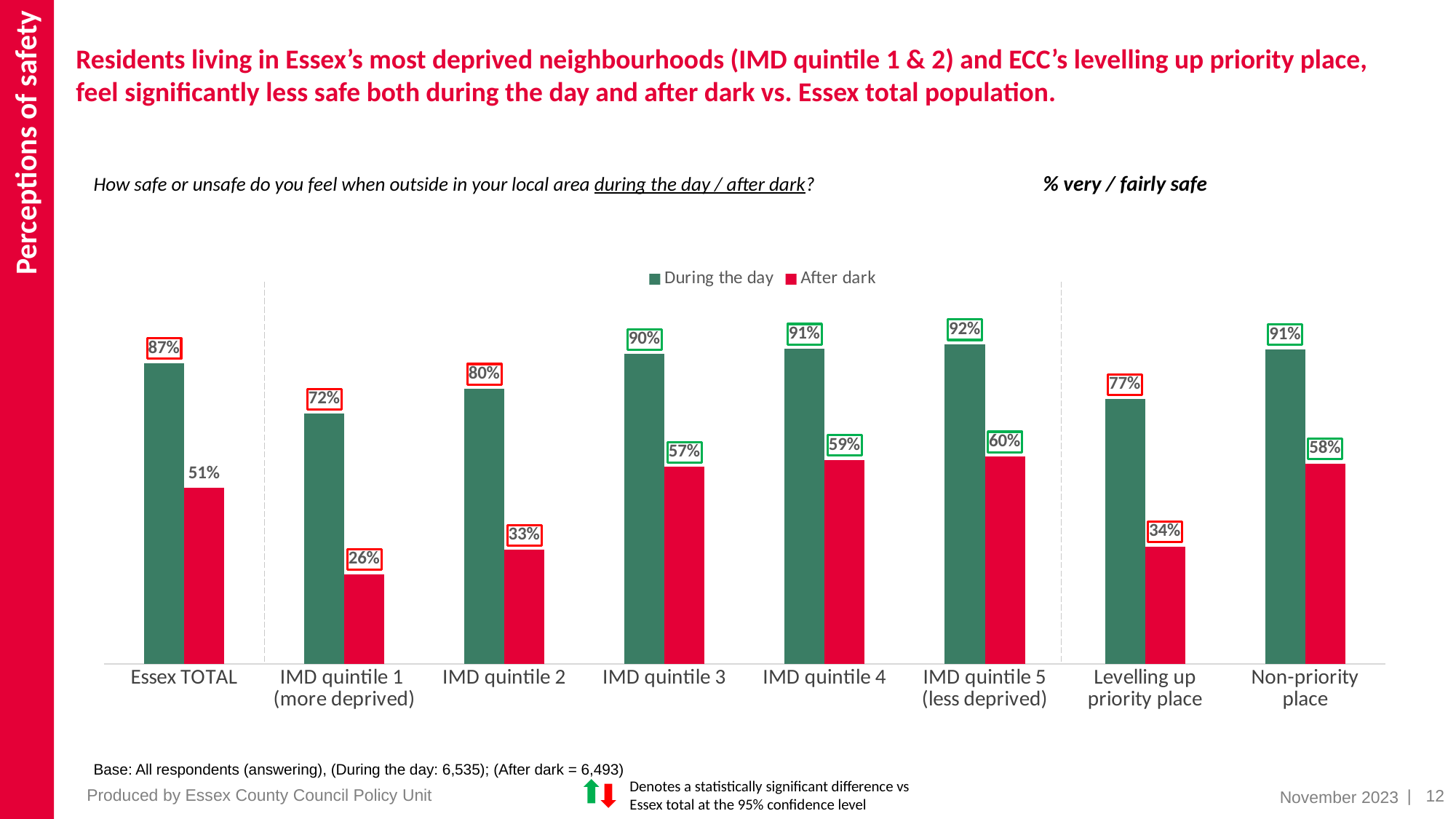
What is the 'After dark' value for IMD quintile 1 (more deprived)? 26% What kind of chart is shown on the slide? Bar chart What is the difference between the 'During the day' and 'After dark' values for Essex TOTAL? 36 percentage points How many categories are shown on the x axis? 8 Which category has the highest 'During the day' value? IMD quintile 5 (less deprived) Which is larger: the 'After dark' value for IMD quintile 2 or for Levelling up priority place? Levelling up priority place What colour represents the 'After dark' series? Red What is the 'After dark' value for Levelling up priority place? 34% What is the 'During the day' value for Essex TOTAL? 87% How many series does the legend list? 2 Which category has the lowest 'After dark' value? IMD quintile 1 (more deprived) Do the 'After dark' values rise or fall from IMD quintile 1 to IMD quintile 5? Rise